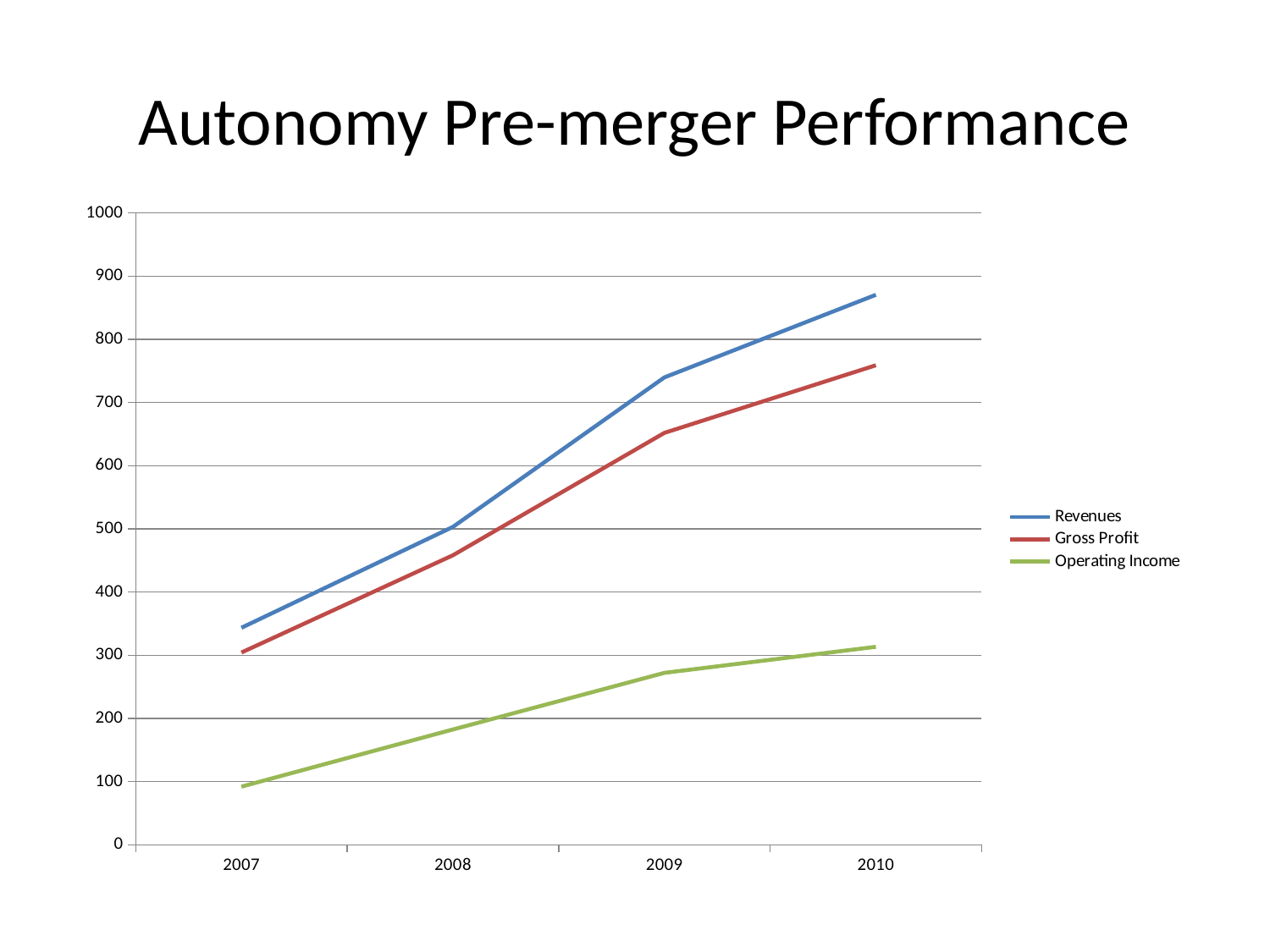
Is the value for Revenues in 2010 greater or less than 800? greater Is the value for Operating Income in 2009 greater or less than 200? greater How many years are plotted along the x axis? 4 Do Revenues rise or fall from 2007 to 2010? rise Which series has the lowest value in 2007? Operating Income Is the value for Gross Profit in 2007 greater or less than 400? less Which is larger in 2009, Gross Profit or Operating Income? Gross Profit Which series has the highest value in 2010? Revenues How many series does the legend list? 3 What kind of chart is shown on the slide? line chart Does Operating Income rise or fall from 2007 to 2010? rise What is the title of the chart? Autonomy Pre-merger Performance